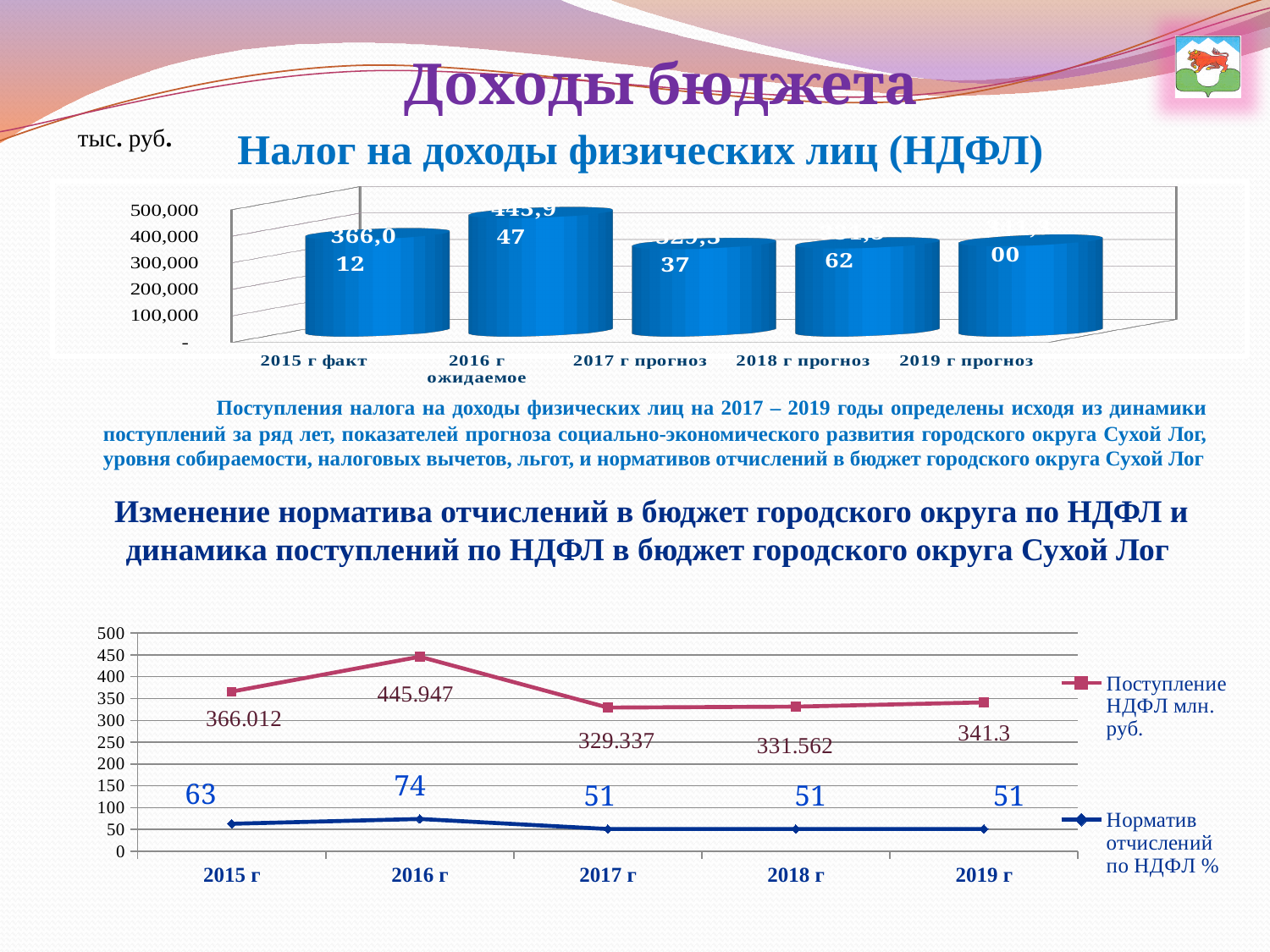
In the bottom line chart, what is the value of Поступление НДФЛ млн. руб. for 2019 г? 341.3 In the bottom line chart, which year has the lowest value of Поступление НДФЛ млн. руб.? 2017 г What kind of chart is the top chart titled Налог на доходы физических лиц (НДФЛ)? bar chart In the bottom line chart, what is the value of Норматив отчислений по НДФЛ % for 2016 г? 74 How many categories are shown on the x axis of the top bar chart Налог на доходы физических лиц (НДФЛ)? 5 In the bottom line chart, which year has the highest value of Поступление НДФЛ млн. руб.? 2016 г In the bottom line chart, which is larger: Поступление НДФЛ млн. руб. for 2015 г or for 2018 г? 2015 г How many series does the legend of the bottom line chart list? 2 In the top bar chart Налог на доходы физических лиц (НДФЛ), is the value for 2016 г ожидаемое greater or less than 400,000? greater In the bottom line chart, what is the value of Поступление НДФЛ млн. руб. for 2016 г? 445.947 In the bottom line chart, what is the difference between the Норматив отчислений по НДФЛ % values for 2016 г and 2017 г? 23 In the bottom line chart, does the Норматив отчислений по НДФЛ % value rise or fall from 2016 г to 2017 г? fall